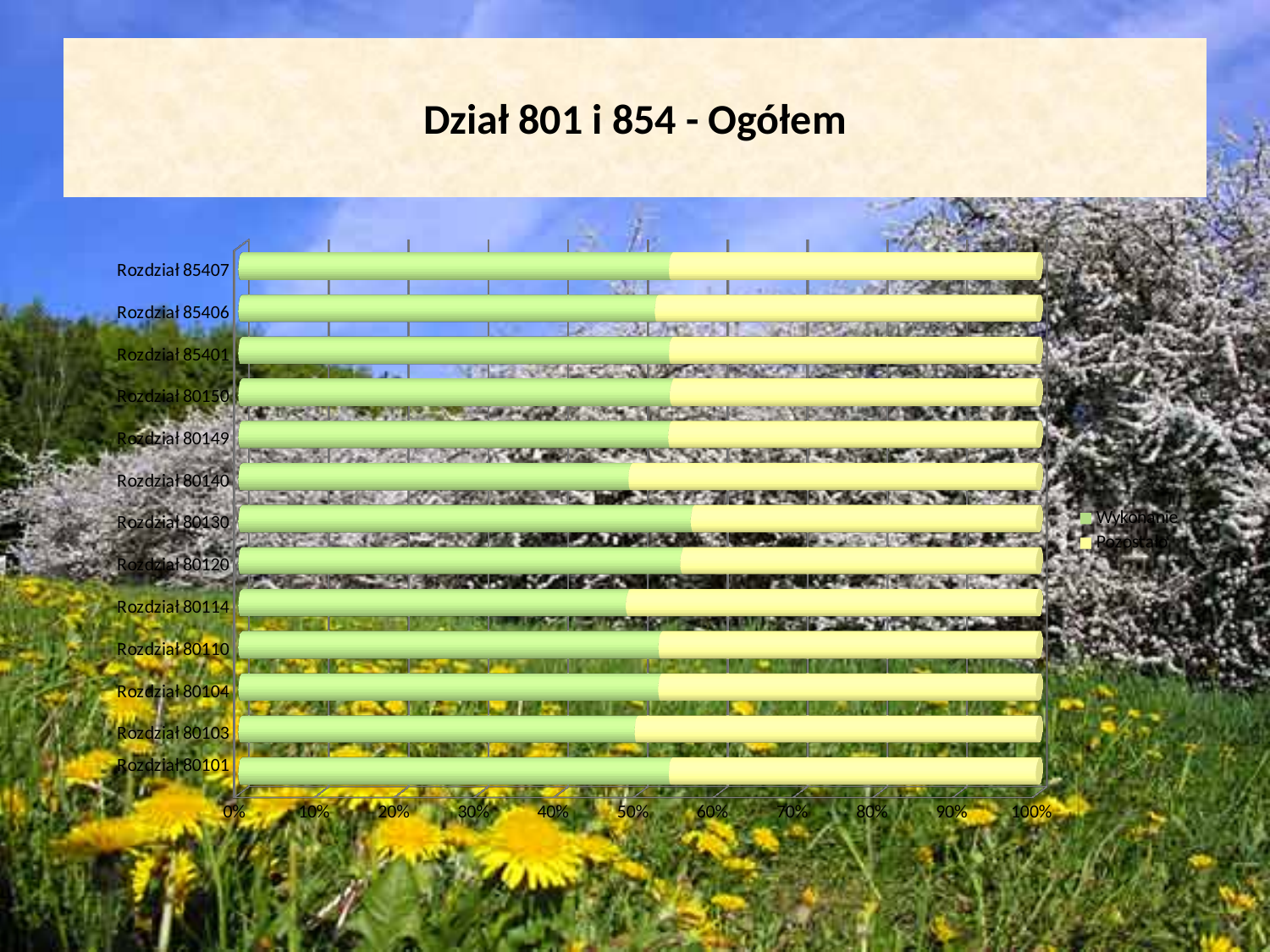
What is the title of the chart? Dział 801 i 854 - Ogółem Which has the larger Wykonanie value, Rozdział 80120 or Rozdział 80140? Rozdział 80120 Is the Wykonanie value for Rozdział 80130 greater or less than 50%? greater How many categories (Rozdział entries) are plotted on the chart? 13 Which series is shown in green? Wykonanie Is the Wykonanie value for Rozdział 85406 greater or less than 40%? greater What kind of chart is shown on the slide? Stacked bar chart Is the Wykonanie value for Rozdział 80114 greater or less than 60%? less What is the highest value shown on the horizontal axis? 100% Which has the larger Wykonanie value, Rozdział 80130 or Rozdział 80114? Rozdział 80130 How many series does the legend list? 2